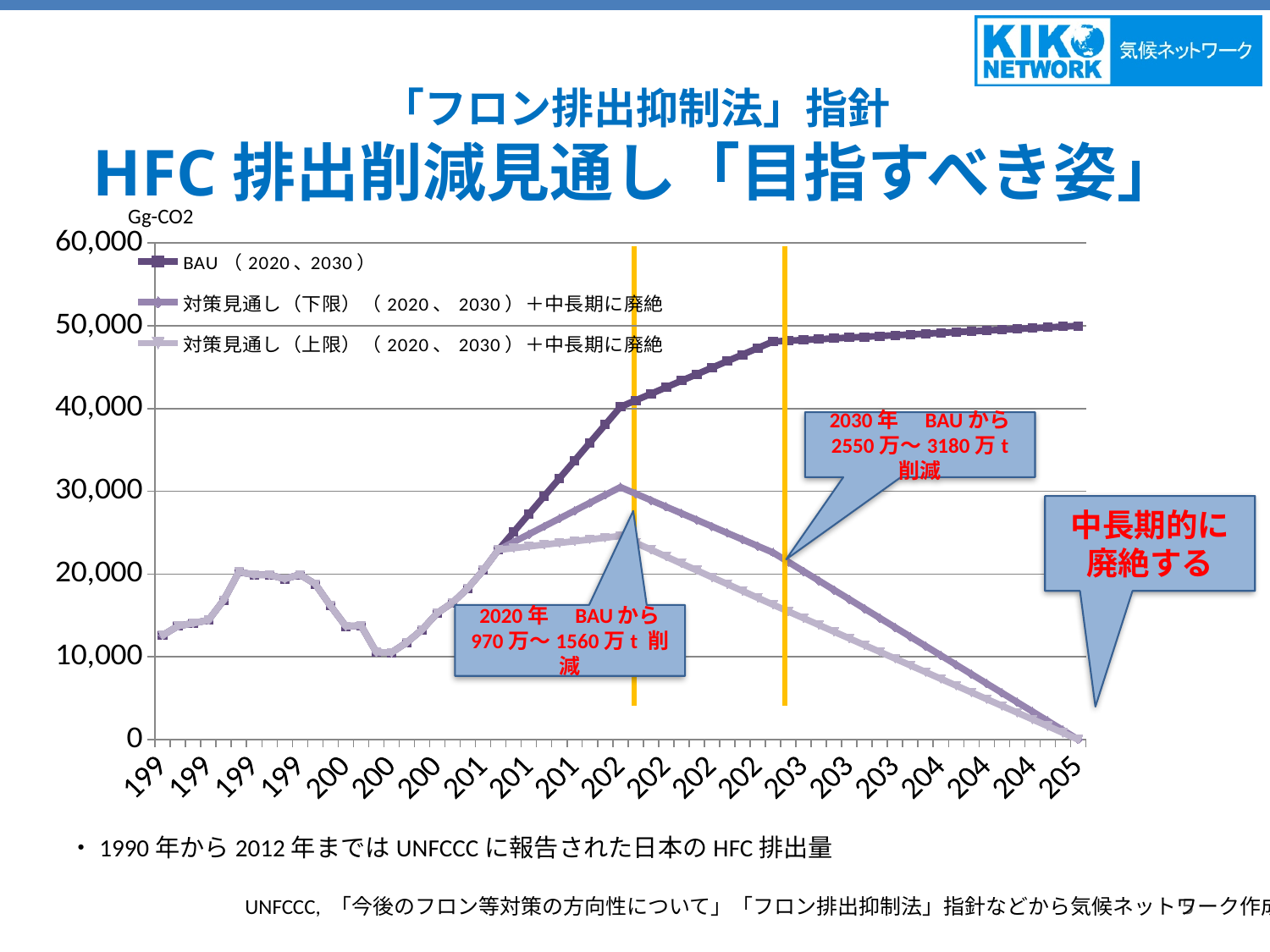
Is the value of the BAU series at the right end of the chart greater or less than 40,000? greater At the 2030 marker line, which is larger: the BAU series or the 対策見通し（下限） series? BAU What kind of chart is shown on the slide? line chart How many series does the legend list? 3 Is the value of the 対策見通し（上限） series at the 2030 marker line greater or less than 20,000? less What unit is shown at the top of the vertical axis? Gg-CO2 Which series has the highest value at the right end of the chart? BAU（2020、2030） Does the BAU series rise or fall from the 2020 marker line to the right end of the chart? rise According to the annotation, by how much is the 2030 reduction from BAU? 2550万～3180万t Do the 対策見通し（下限） and 対策見通し（上限） series rise or fall from the 2020 marker line to the right end of the chart? fall Is the value of the BAU series at the 2020 marker line greater or less than 30,000? greater What is the highest value shown on the vertical axis? 60,000